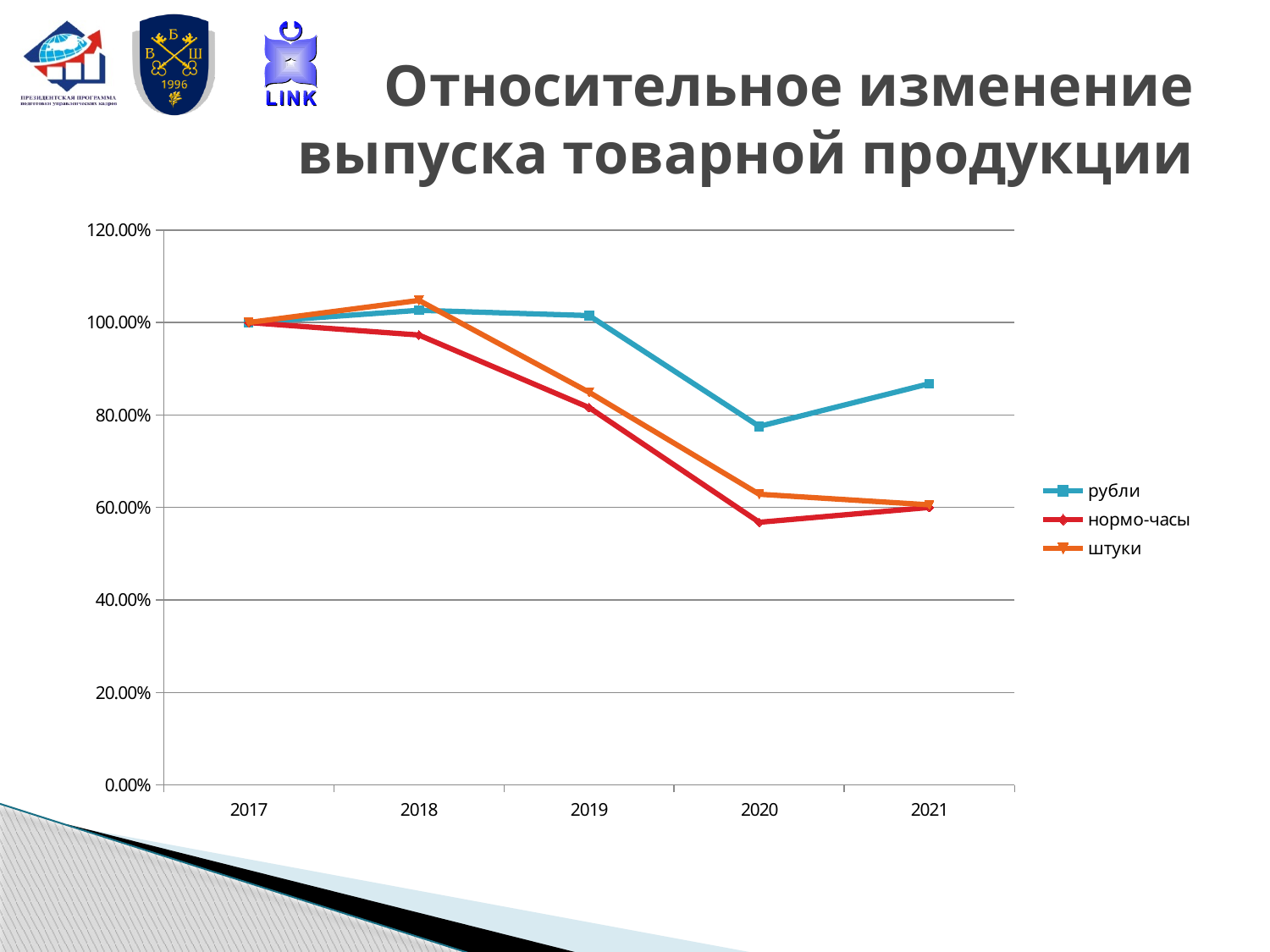
What kind of chart is shown on the slide? line chart Which series has the lowest value in 2020? нормо-часы Is the value for нормо-часы in 2020 greater or less than 60.00%? less In 2019, which is larger: the value for рубли or the value for нормо-часы? рубли Is the value for рубли in 2021 greater or less than 80.00%? greater What is the value for рубли in 2017? 100.00% How many series does the legend list? 3 Does the value for нормо-часы rise or fall from 2017 to 2020? fall Which series has the highest value in 2020? рубли How many years are shown on the x axis? 5 Is the value for рубли in 2020 greater or less than 80.00%? less